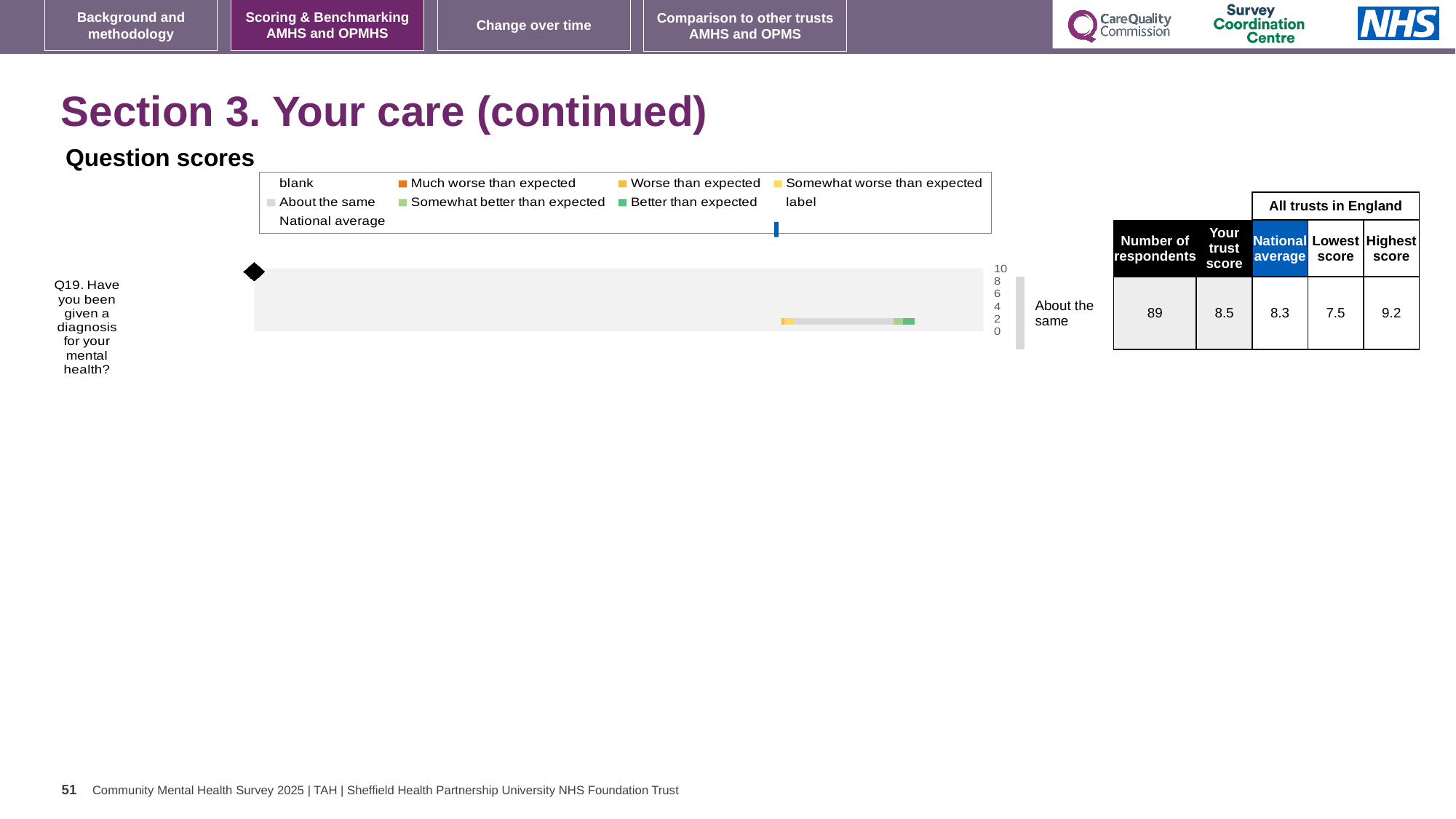
What is the lowest score across all trusts in England for Q19? 7.5 Which question is plotted in the question scores chart? Q19. Have you been given a diagnosis for your mental health? Which is larger for Q19, the trust's score or the national average? the trust's score What is the highest score across all trusts in England for Q19? 9.2 What is the difference between the highest and lowest trust scores for Q19? 1.7 How many respondents answered Q19 according to the table beside the chart? 89 What kind of chart is used to show the Q19 question score? bar chart What benchmark category is shown next to the bar for Q19? About the same What colour does the legend use for 'Better than expected'? green What is the trust's score for Q19 shown in the table beside the chart? 8.5 How many questions are plotted in the question scores chart? 1 What is the national average for Q19 shown in the table beside the chart? 8.3